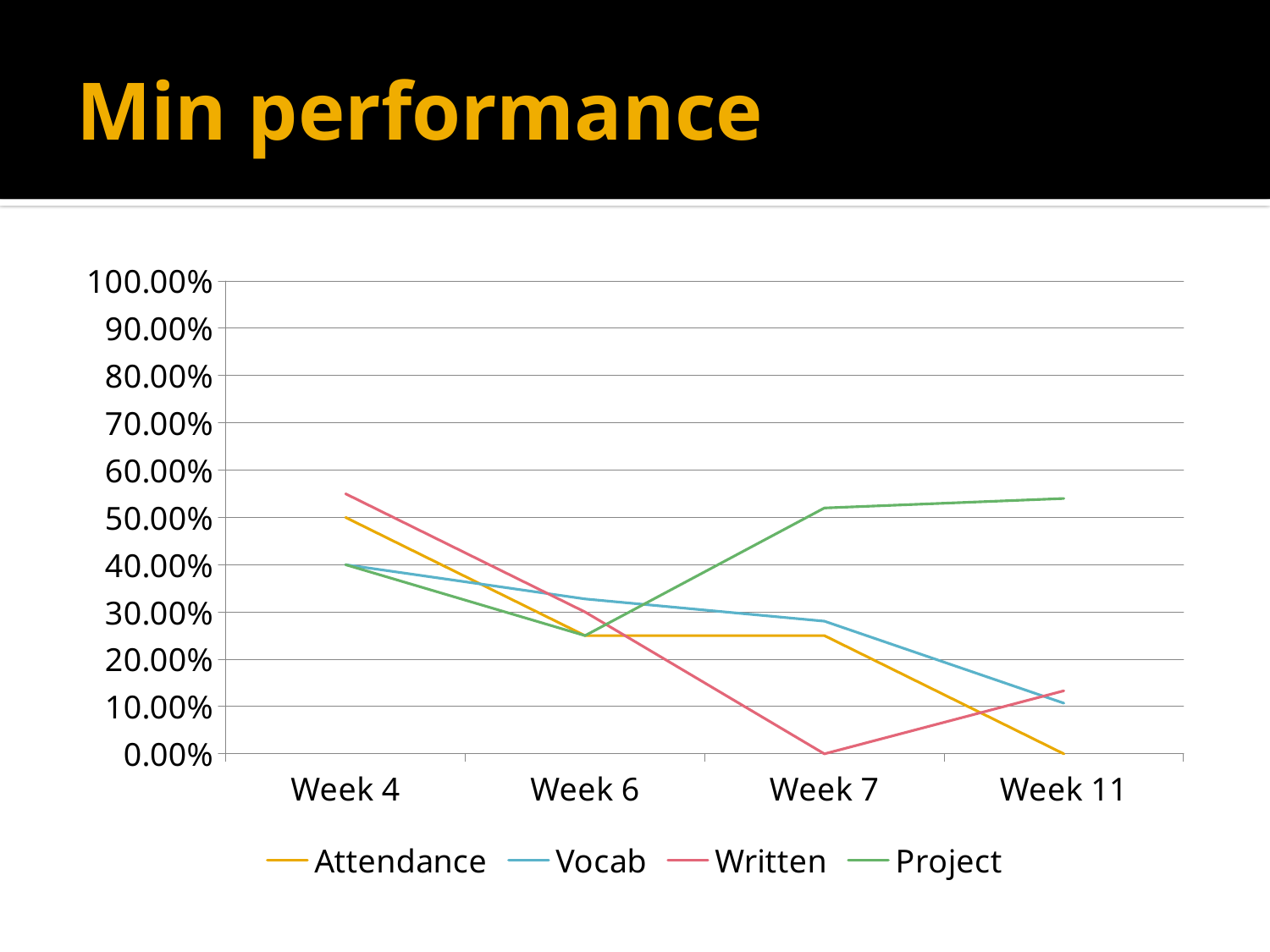
What is the Written value at Week 7? 0.00% Does the Attendance line rise or fall from Week 4 to Week 11? Fall What kind of chart is shown on the slide? Line chart At Week 4, which is larger: the Written value or the Attendance value? Written Is the Written value at Week 4 greater or less than 50.00%? greater How many weeks are shown on the x axis? 4 What is the Attendance value at Week 4? 50.00% How many series does the legend list? 4 Which series has the highest value at Week 11? Project Is the Project value at Week 11 greater or less than 50.00%? greater What is the Attendance value at Week 11? 0.00% Which series has the lowest value at Week 7? Written